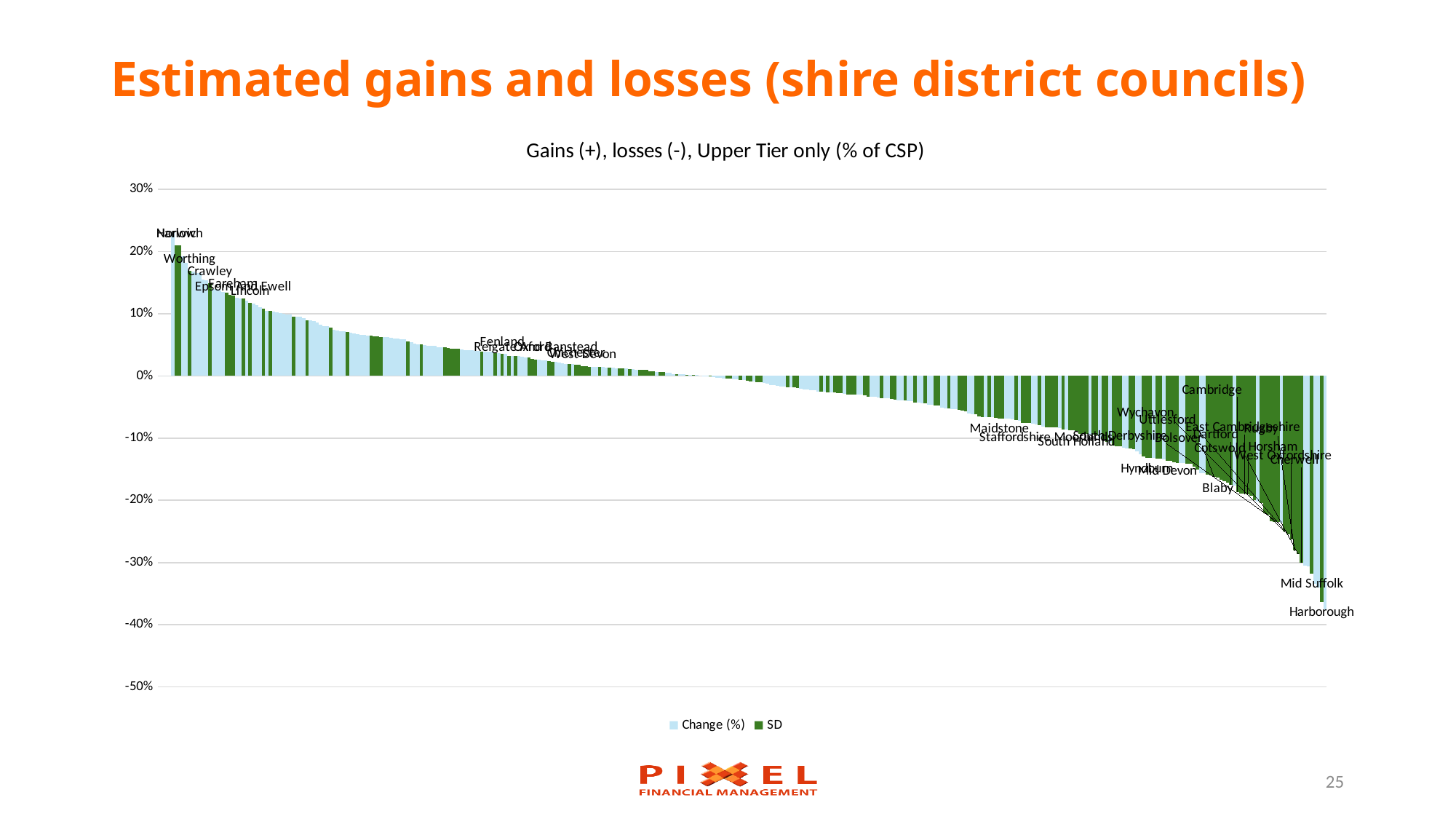
Which has the larger value, Worthing or Harborough? Worthing How many series does the legend list? 2 What is the title of the chart? Gains (+), losses (-), Upper Tier only (% of CSP) Do the values rise or fall moving from left to right along the x axis? fall Is the value for Mid Suffolk greater or less than -20%? less Is the value for Harborough greater or less than -30%? less Is the value for Worthing greater or less than 10%? greater What kind of chart is shown on the slide? bar chart Which council has the lowest value in the chart? Harborough What are the two series named in the legend? Change (%) and SD